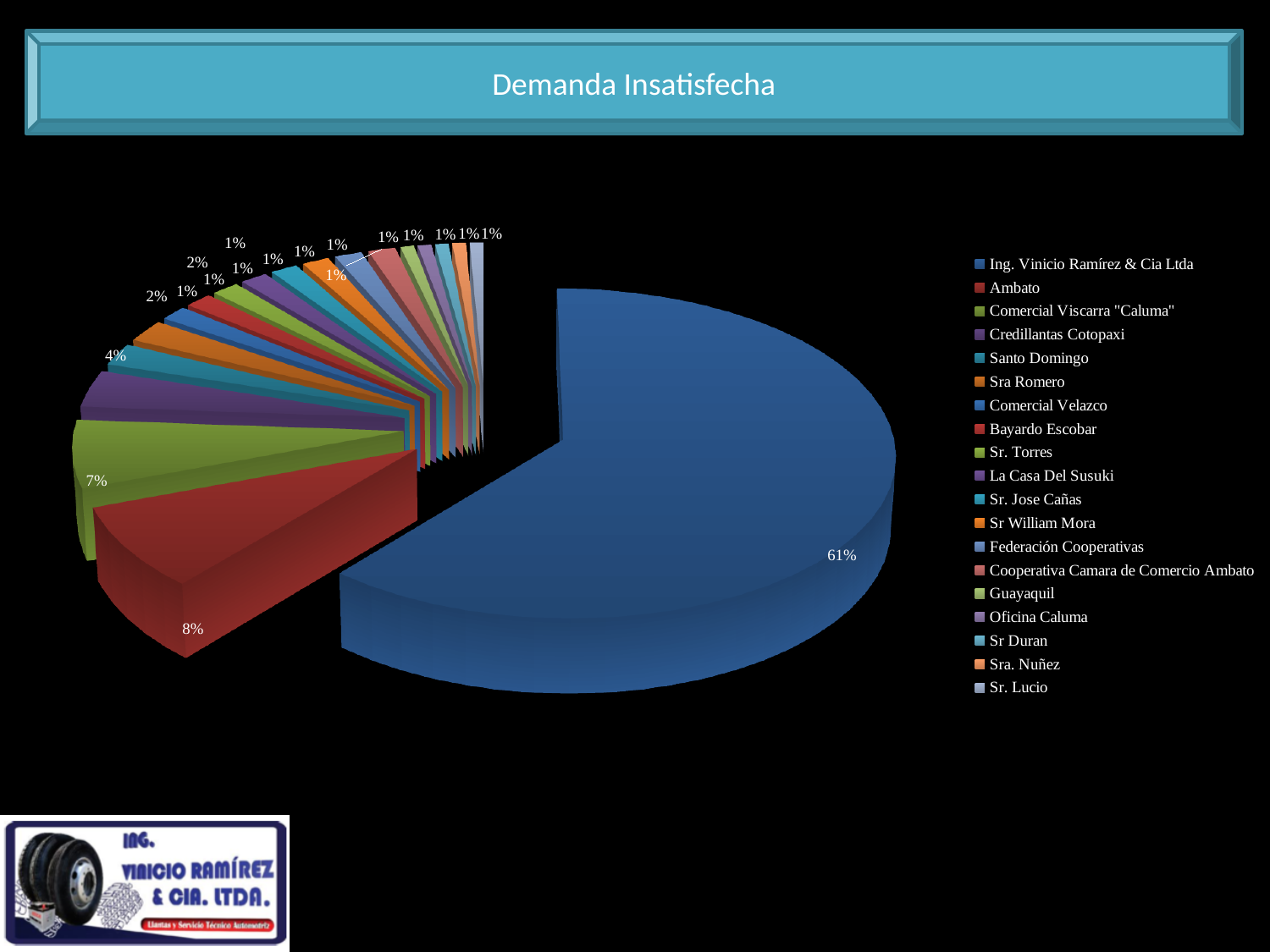
Which is larger, the slice for Ambato or the slice for Comercial Viscarra "Caluma"? Ambato Which category has the largest slice of the pie? Ing. Vinicio Ramírez & Cia Ltda What is the difference between the share for Ing. Vinicio Ramírez & Cia Ltda and the share for Ambato? 53% What is the title of the chart? Demanda Insatisfecha What share of the pie does Ing. Vinicio Ramírez & Cia Ltda hold? 61% What is the value shown for Ambato? 8% What kind of chart is shown on the slide? pie chart What is the value shown for Santo Domingo? 2% What is the value shown for Credillantas Cotopaxi? 4% What is the value shown for Comercial Viscarra "Caluma"? 7% What colour is the slice for Ing. Vinicio Ramírez & Cia Ltda? blue How many categories does the legend list? 19